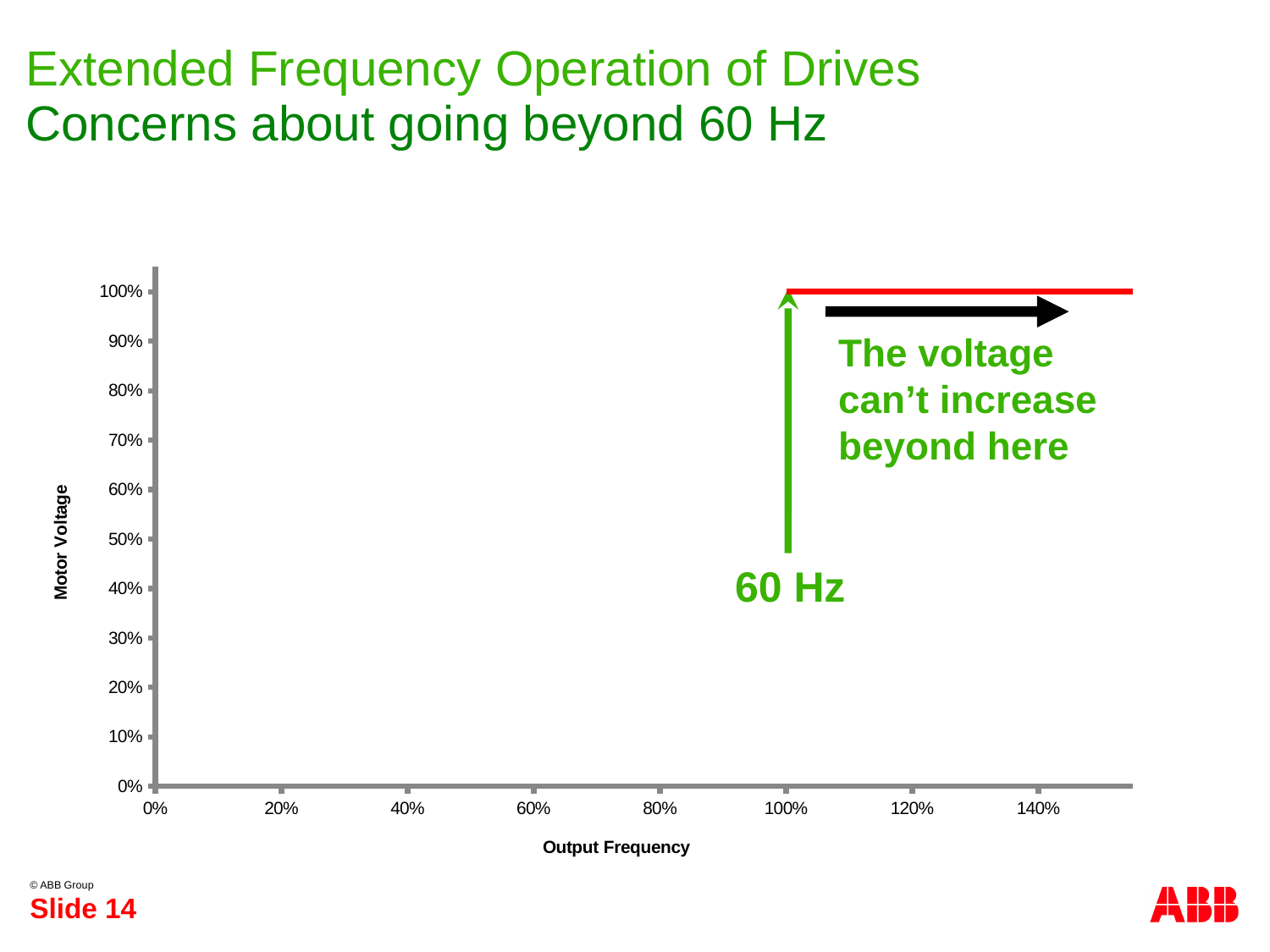
At what output frequency does the red line begin? 100% What kind of chart is shown on the slide? line chart At what motor voltage level does the red line sit? 100% What frequency in Hz is marked at the 100% output frequency point? 60 Hz Is the motor voltage at 120% output frequency greater or less than 90%? greater What is the highest value labelled on the vertical axis? 100% Is the motor voltage at 140% output frequency greater or less than 50%? greater What is the label of the horizontal axis of the chart? Output Frequency How many labelled tick marks are on the horizontal axis? 8 What is the label of the vertical axis of the chart? Motor Voltage As output frequency increases beyond 100%, does the motor voltage rise, fall, or stay flat? stays flat